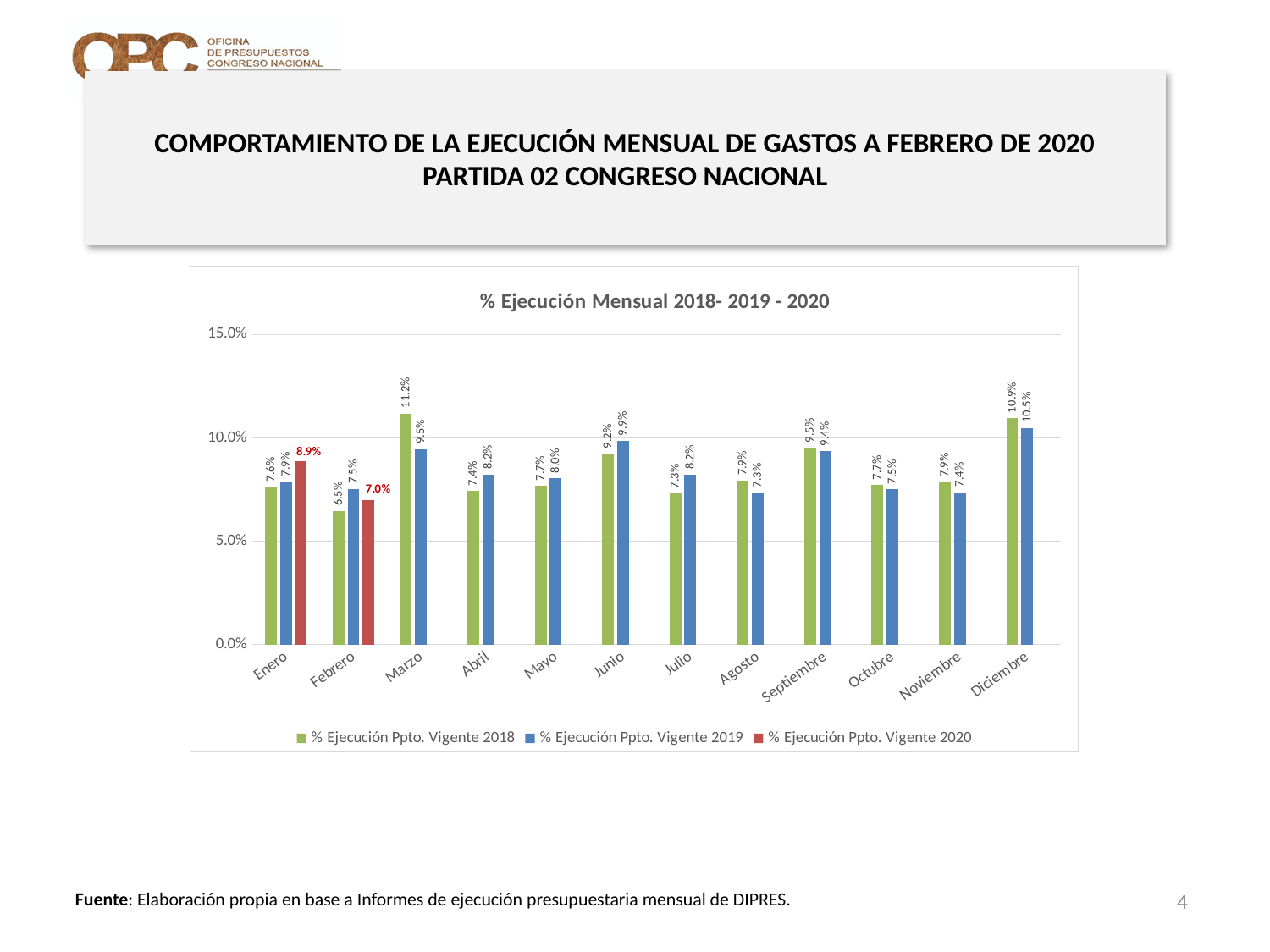
For Junio, which series has the larger value, 2018 or 2019? 2019 What is the value for Enero in the % Ejecución Ppto. Vigente 2020 series? 8.9% What is the value for Marzo in the % Ejecución Ppto. Vigente 2018 series? 11.2% Is the value for Diciembre in the 2018 series greater or less than 10.0%? greater How many series does the legend list? 3 What is the title of the chart? % Ejecución Mensual 2018- 2019 - 2020 What is the value for Diciembre in the % Ejecución Ppto. Vigente 2019 series? 10.5% How many months are shown on the x axis? 12 Which month has the highest value in the % Ejecución Ppto. Vigente 2018 series? Marzo What kind of chart is shown on the slide? bar chart Which month has the lowest value in the % Ejecución Ppto. Vigente 2018 series? Febrero What is the difference between the 2019 and 2018 values for Febrero? 1.0%